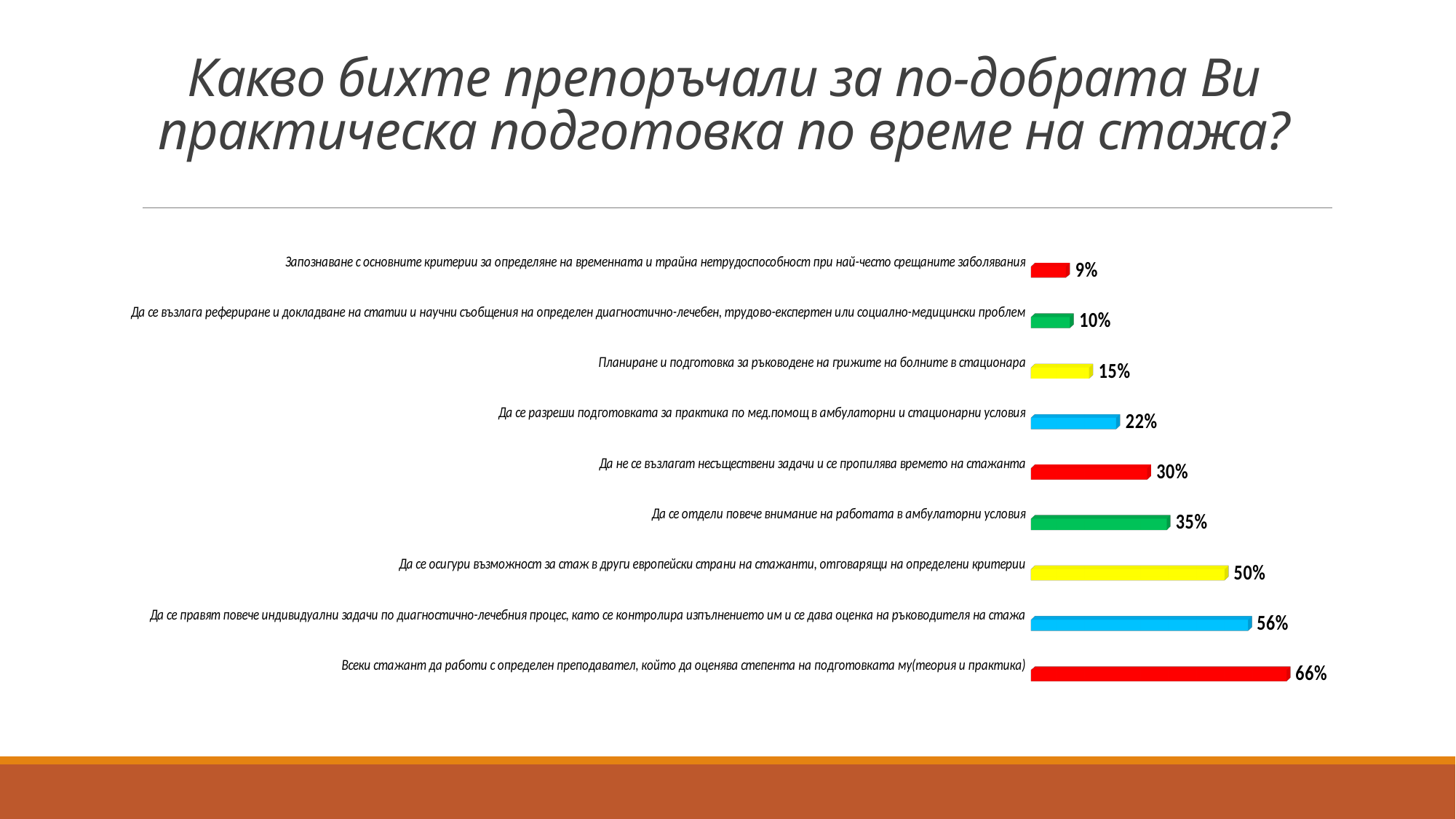
What is the value for "Да се осигури възможност за стаж в други европейски страни на стажанти, отговарящи на определени критерии"? 50% What is the value for "Планиране и подготовка за ръководене на грижите на болните в стационара"? 15% What is the difference between the value for "Да се правят повече индивидуални задачи по диагностично-лечебния процес..." (56%) and "Да не се възлагат несъществени задачи и се пропилява времето на стажанта" (30%)? 26% What is the value for "Всеки стажант да работи с определен преподавател, който да оценява степента на подготовката му(теория и практика)"? 66% What colour is the bar for the category with the value 22%? Blue Do the bar values increase or decrease going from the top category to the bottom category? Increase What is the value for "Да се отдели повече внимание на работата в амбулаторни условия"? 35% How many categories (recommendations) are plotted in the chart? 9 What type of chart is shown on the slide? Bar chart Which is larger: the value for "Да се разреши подготовката за практика по мед.помощ в амбулаторни и стационарни условия" or for "Да се възлага рефериране и докладване на статии и научни съобщения..."? Да се разреши подготовката за практика по мед.помощ в амбулаторни и стационарни условия Which recommendation has the highest value? Всеки стажант да работи с определен преподавател, който да оценява степента на подготовката му(теория и практика) Which recommendation has the lowest value? Запознаване с основните критерии за определяне на временната и трайна нетрудоспособност при най-често срещаните заболявания